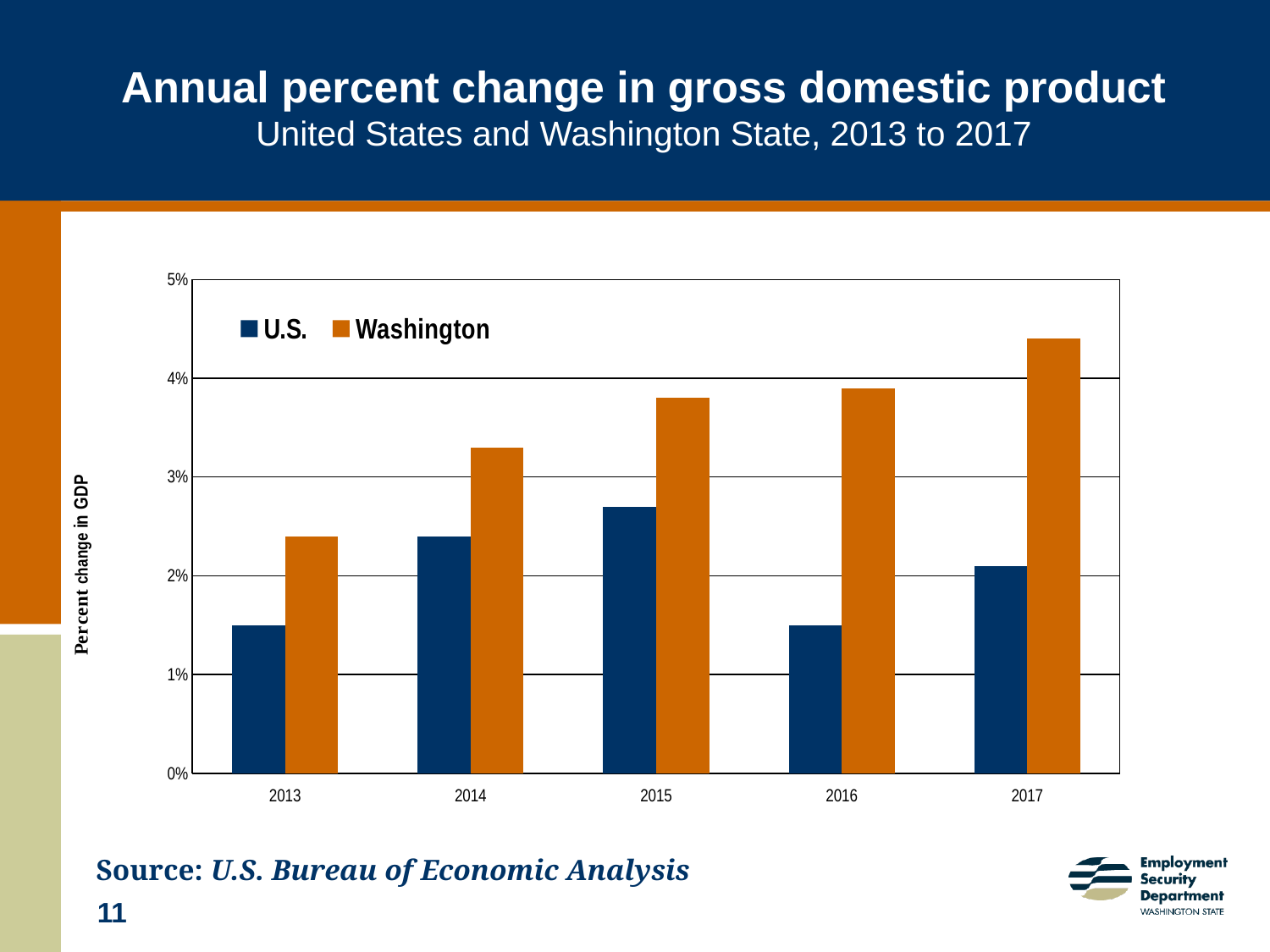
In which year is the Washington value lowest? 2013 Is the Washington value for 2017 greater or less than 4%? greater What kind of chart is shown on the slide? Bar chart How many series does the legend list? 2 What is the title of the vertical axis? Percent change in GDP Do the Washington values rise or fall from 2013 to 2017? Rise How many years are shown on the x axis? 5 Which is larger in 2016, the U.S. value or the Washington value? Washington In which year is the Washington value highest? 2017 Is the U.S. value for 2016 greater or less than 2%? less In which year is the U.S. value highest? 2015 Is the Washington value for 2014 greater or less than 3%? greater